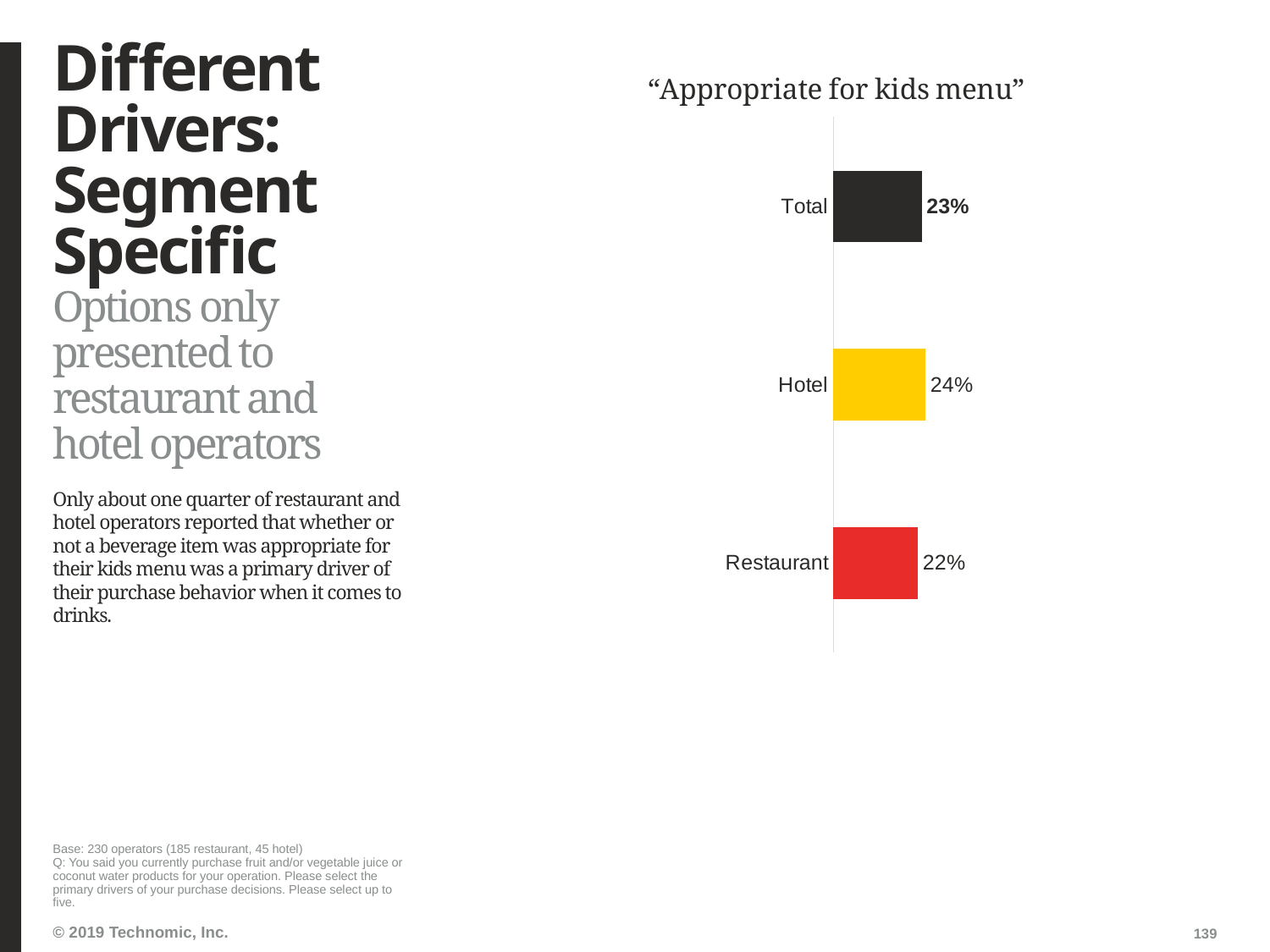
What is the value for Restaurant in the "Appropriate for kids menu" chart? 22% Which category has the lowest value in the "Appropriate for kids menu" chart? Restaurant What colour is the Hotel bar in the "Appropriate for kids menu" chart? Yellow What is the difference between the Hotel and Restaurant values in the "Appropriate for kids menu" chart? 2% What is the value for Total in the "Appropriate for kids menu" chart? 23% What is the value for Hotel in the "Appropriate for kids menu" chart? 24% What is the title of the chart on the slide? "Appropriate for kids menu" How many categories are shown in the "Appropriate for kids menu" chart? 3 Which category has the highest value in the "Appropriate for kids menu" chart? Hotel What kind of chart is shown on the slide? Bar chart Which is larger in the "Appropriate for kids menu" chart, the value for Total or the value for Restaurant? Total